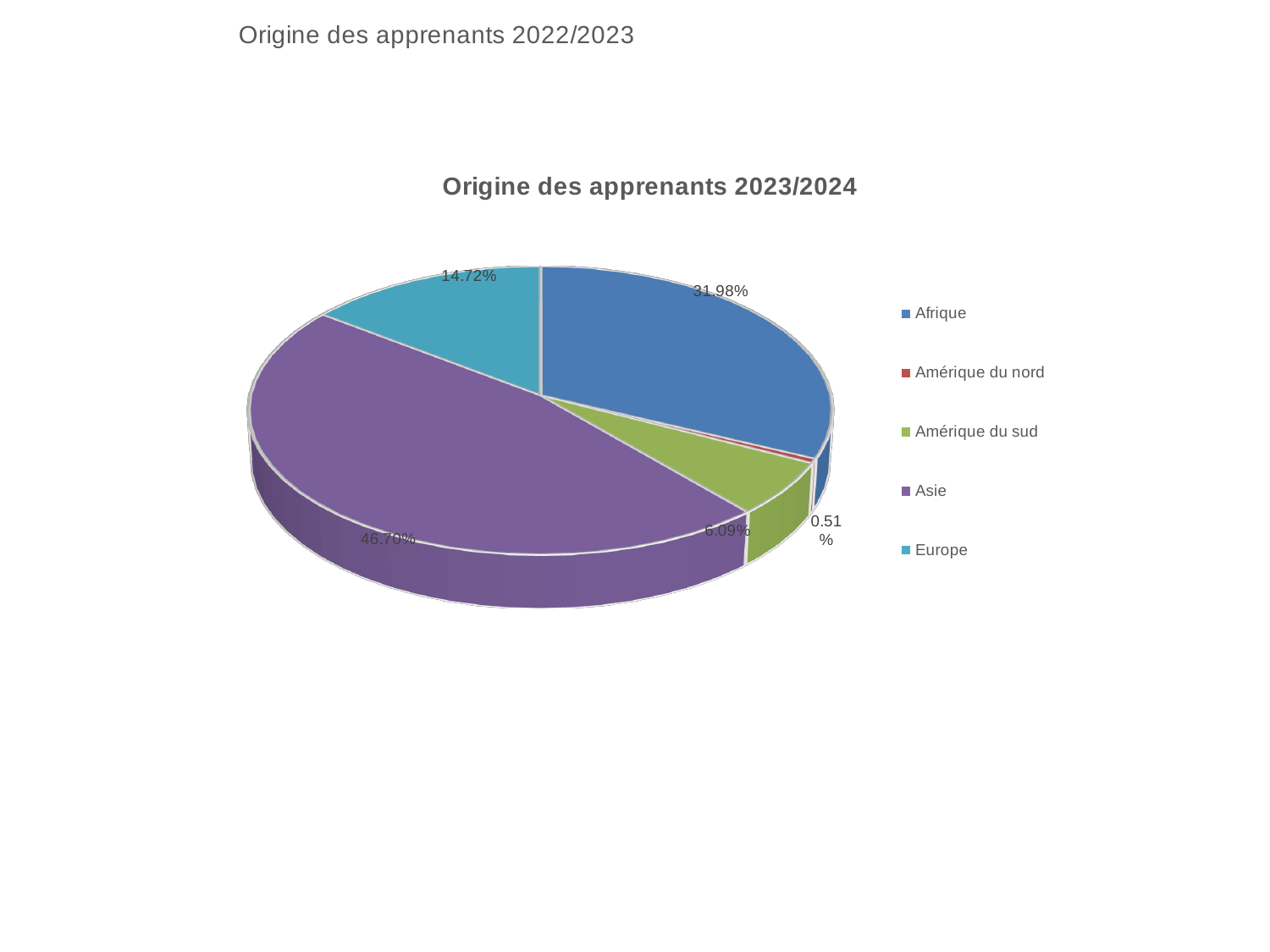
What share of the pie does Asie represent? 46.70% What share of the pie does Amérique du sud represent? 6.09% How many categories does the pie chart show? 5 What share of the pie does Amérique du nord represent? 0.51% What is the difference between the share for Asie and the share for Afrique? 14.72% Which category has the largest slice of the pie? Asie What kind of chart is shown on the slide? Pie chart Which is larger, the share for Afrique or the share for Europe? Afrique What is the title of the chart? Origine des apprenants 2023/2024 Which category has the smallest slice of the pie? Amérique du nord